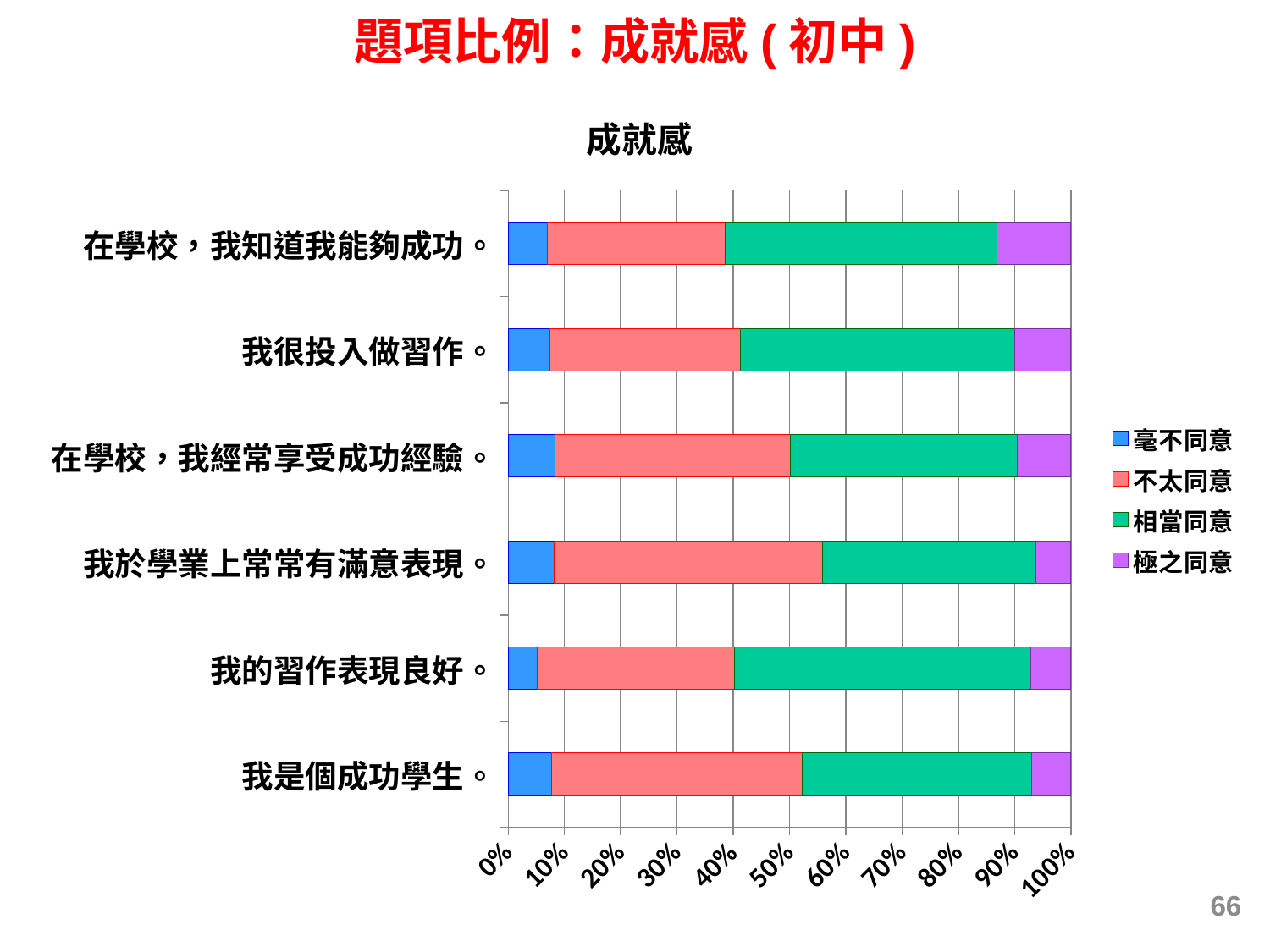
Which has the larger 極之同意 segment: 在學校，我知道我能夠成功 or 我於學業上常常有滿意表現? 在學校，我知道我能夠成功。 Which statement has the smallest 毫不同意 segment? 我的習作表現良好。 What kind of chart is shown on the slide? Stacked bar chart Which statement has the largest 極之同意 segment? 在學校，我知道我能夠成功。 Is the 毫不同意 segment for 我的習作表現良好 greater or less than 10%? less How many statements (categories) are plotted on the chart? 6 What do the four segments of each bar add up to? 100% Is the 相當同意 segment for 在學校，我知道我能夠成功 greater or less than 40%? greater Is the 不太同意 segment for 我於學業上常常有滿意表現 greater or less than 40%? greater How many series does the legend list? 4 What is the title of the chart? 成就感 Which legend entry is shown in green? 相當同意